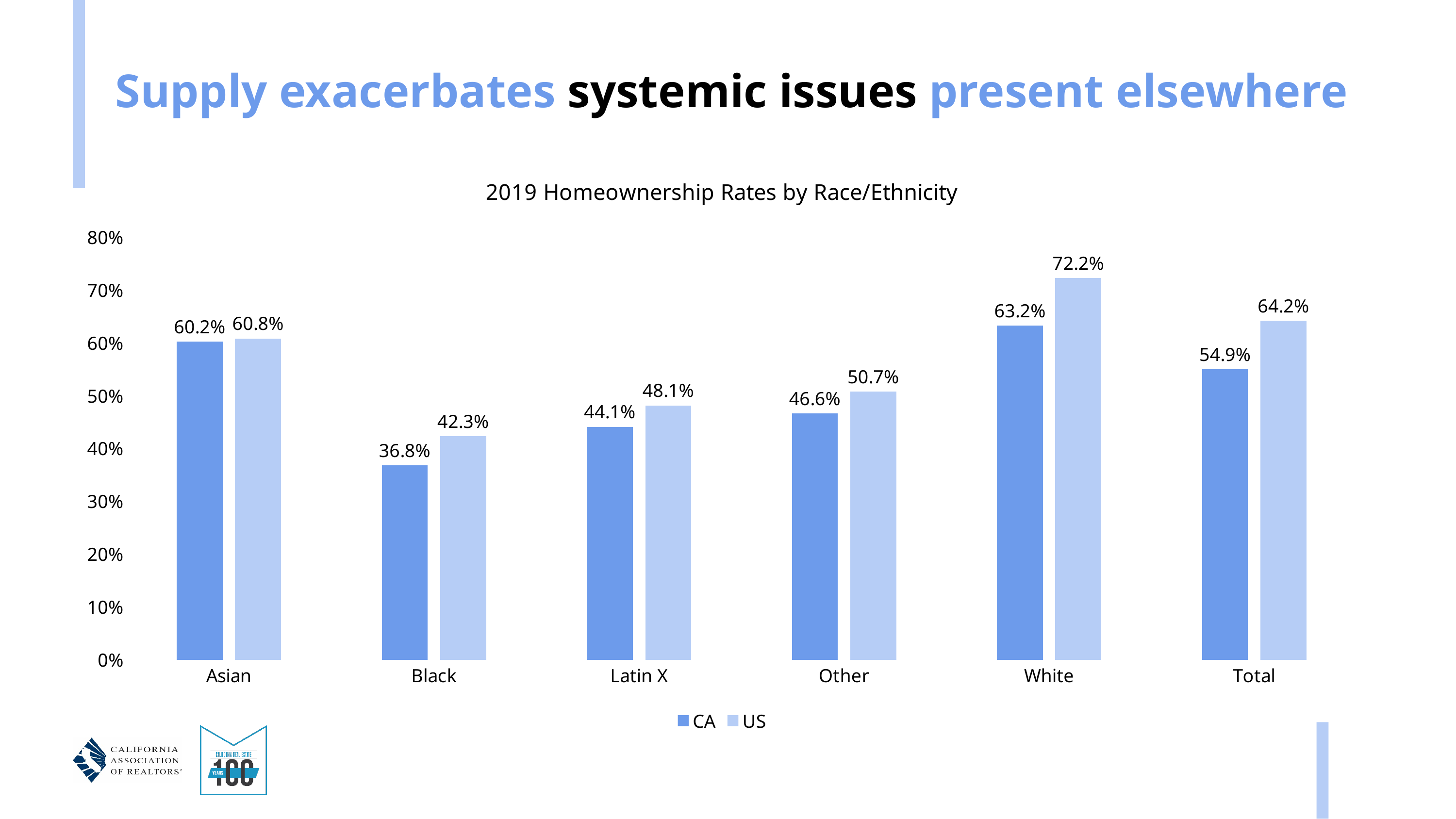
What type of chart is shown on the slide? Bar chart Which is larger, the CA rate for Other households or the CA rate for Latin X households? Other Is the CA homeownership rate for White households greater or less than 60%? greater Which category has the highest US homeownership rate? White What is the CA homeownership rate for Latin X households? 44.1% How many series does the legend list? 2 Which category has the lowest CA homeownership rate? Black How many categories are shown on the x axis? 6 What is the US homeownership rate for White households? 72.2% What is the difference between the US and CA homeownership rates for Black households? 5.5% What is the difference between the US and CA homeownership rates for the Total category? 9.3% What is the CA homeownership rate for Black households? 36.8%